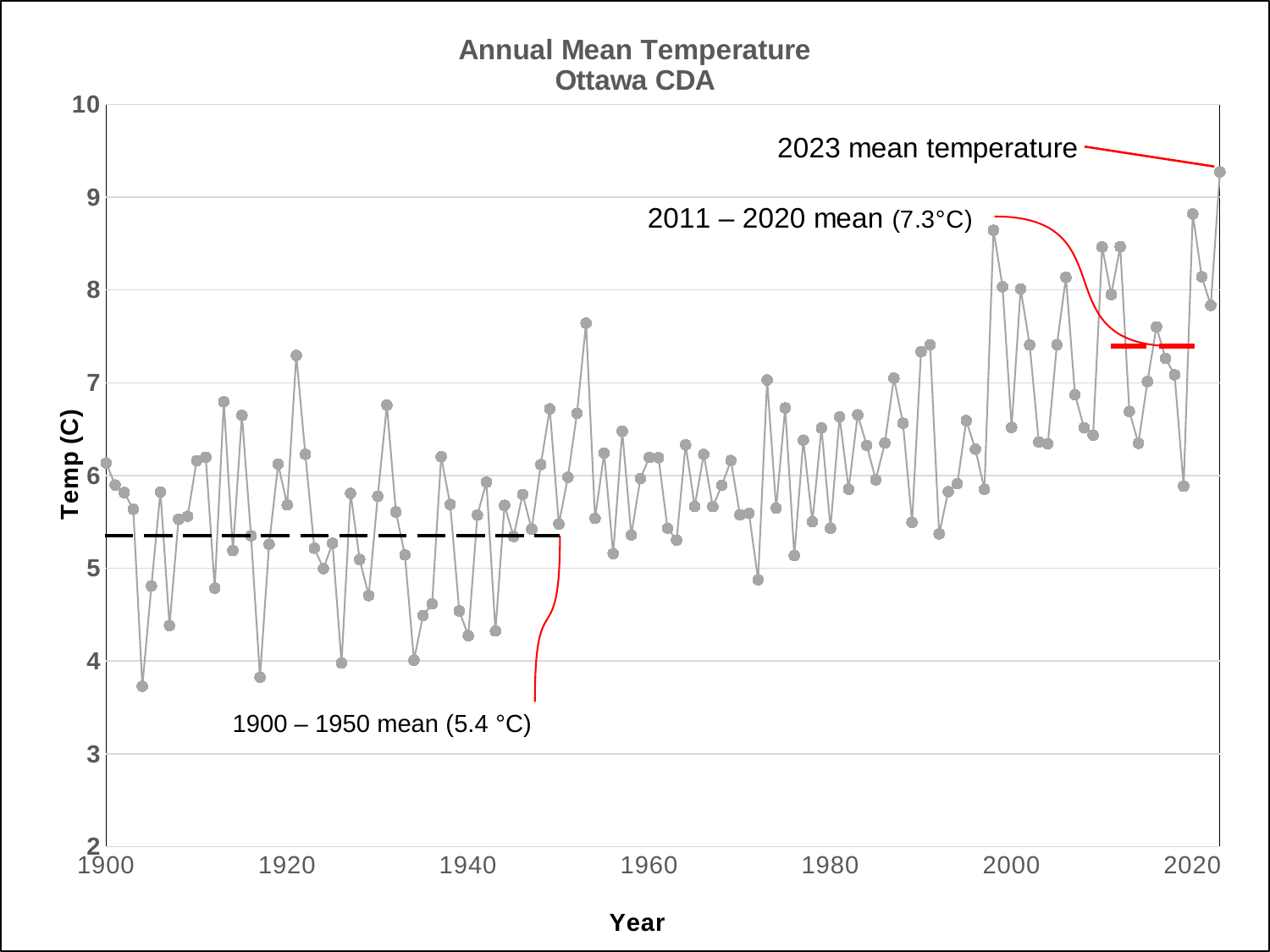
Is the value for 1998 greater or less than 8? greater What is the label on the vertical axis of the chart? Temp (C) Overall, do the annual mean temperatures rise or fall from 1900 to 2023? rise What is the 2011 – 2020 mean temperature shown on the chart? 7.3°C Is the 2023 mean temperature greater or less than 9? greater What is the difference between the 2011 – 2020 mean and the 1900 – 1950 mean? 1.9 °C What is the title of the chart? Annual Mean Temperature Ottawa CDA What is the 1900 – 1950 mean temperature shown on the chart? 5.4 °C Which is larger, the 1900 – 1950 mean or the 2011 – 2020 mean? 2011 – 2020 mean What kind of chart is shown on the slide? line chart Which year has the highest annual mean temperature on the chart? 2023 Is the value for 1904 greater or less than 4? less